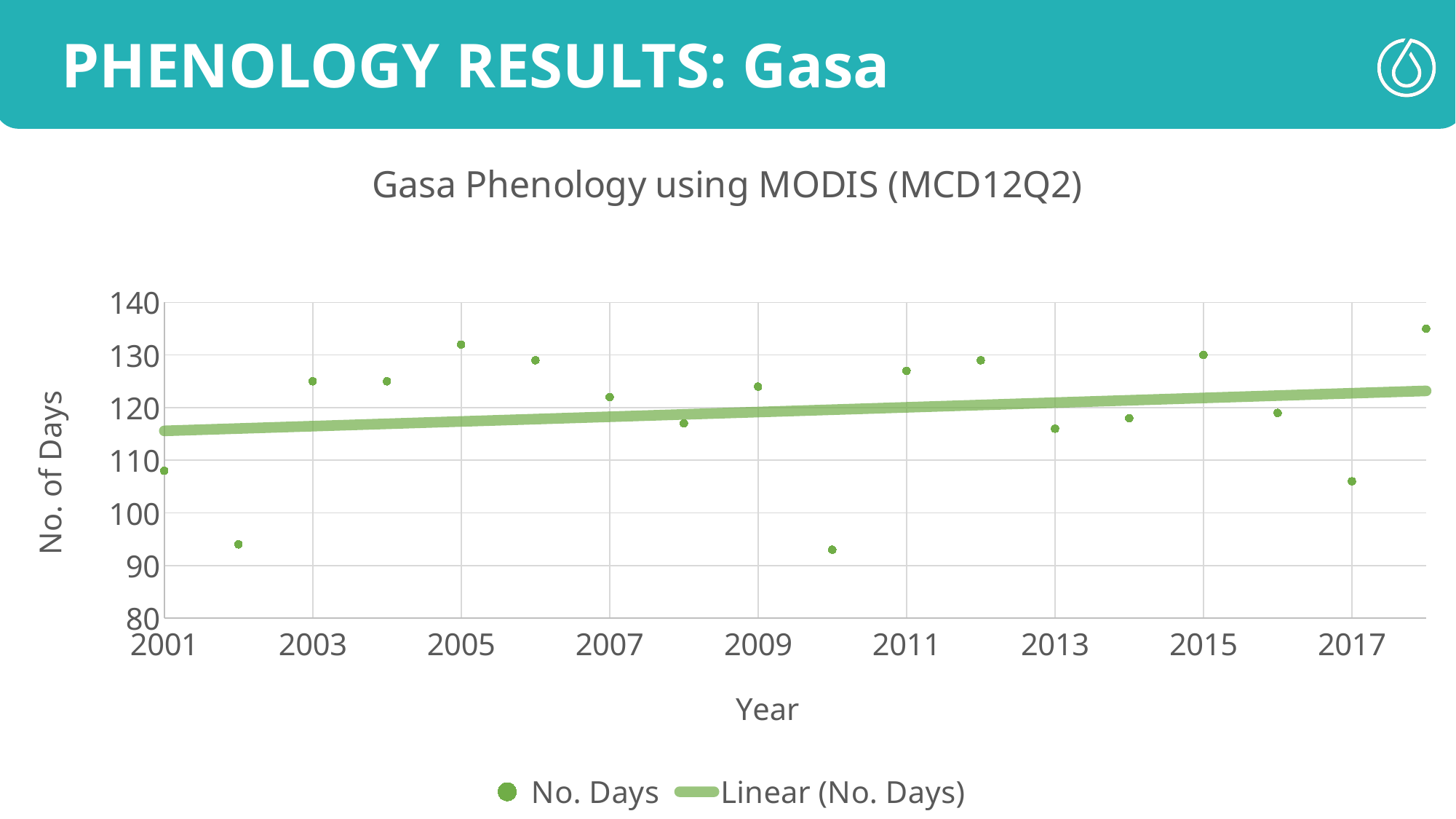
Is the No. Days value for 2005 greater or less than 130? greater Is the No. Days value for 2002 greater or less than 100? less Which year has the larger No. Days value, 2005 or 2007? 2005 What is the title of the chart? Gasa Phenology using MODIS (MCD12Q2) What kind of chart is shown on the slide? scatter chart Does the Linear (No. Days) trendline rise or fall from 2001 to 2018? rise Is the No. Days value for 2010 greater or less than 100? less What is the label of the x axis? Year How many data points are plotted for No. Days? 18 How many series does the legend list? 2 Which year has the highest No. Days value? 2018